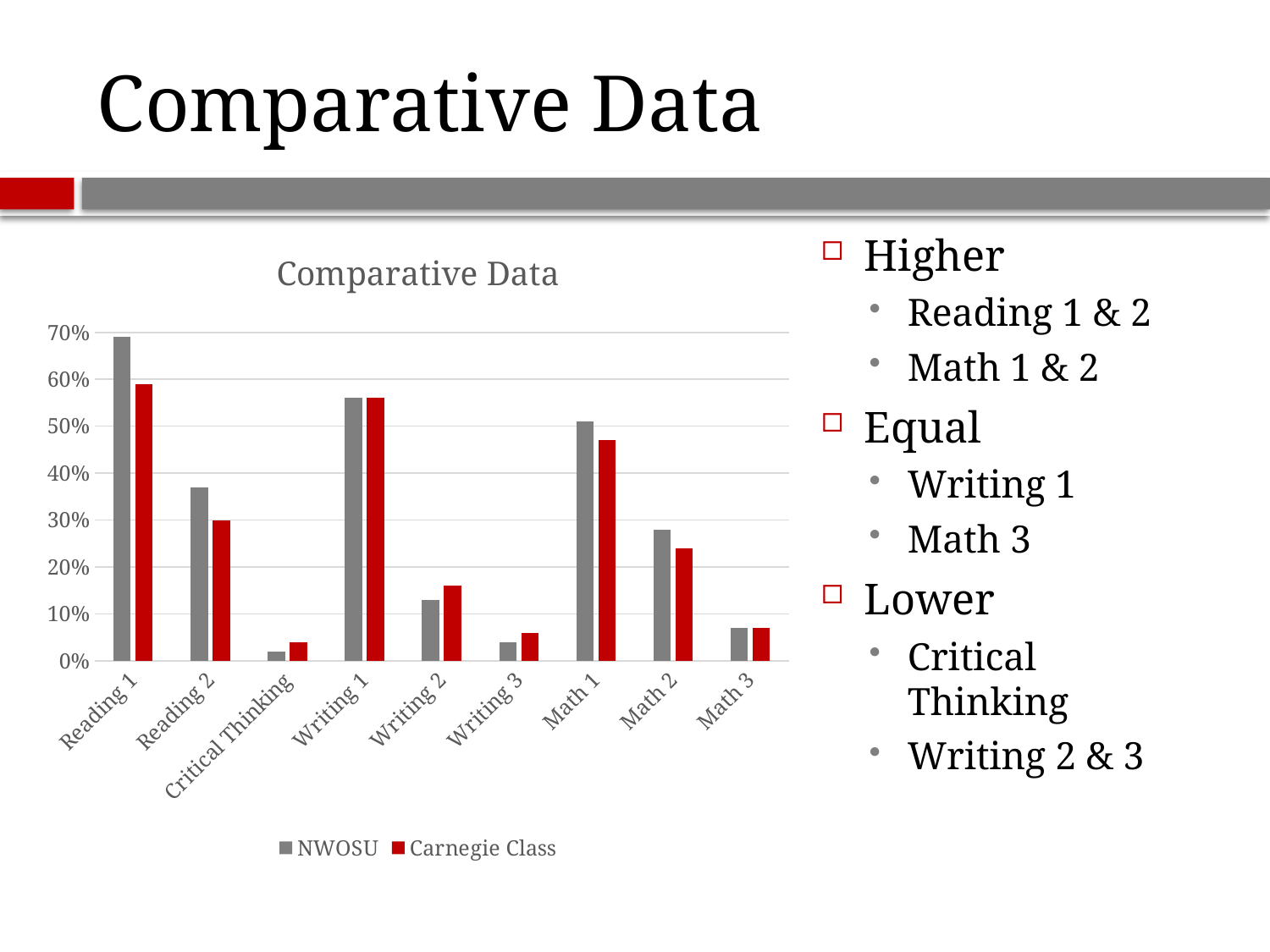
For Writing 2, which series has the larger value, NWOSU or Carnegie Class? Carnegie Class How many series does the chart's legend list? 2 What are the two series named in the chart's legend? NWOSU and Carnegie Class For Reading 1, which series has the larger value, NWOSU or Carnegie Class? NWOSU What is the title of the chart? Comparative Data What kind of chart is shown on the slide? bar chart Is the NWOSU value for Reading 1 greater or less than 60%? greater Which category has the lowest NWOSU value? Critical Thinking Which category has the highest Carnegie Class value? Reading 1 Is the Carnegie Class value for Reading 2 greater or less than 40%? less Which category has the highest NWOSU value? Reading 1 How many categories are shown on the x axis of the chart? 9